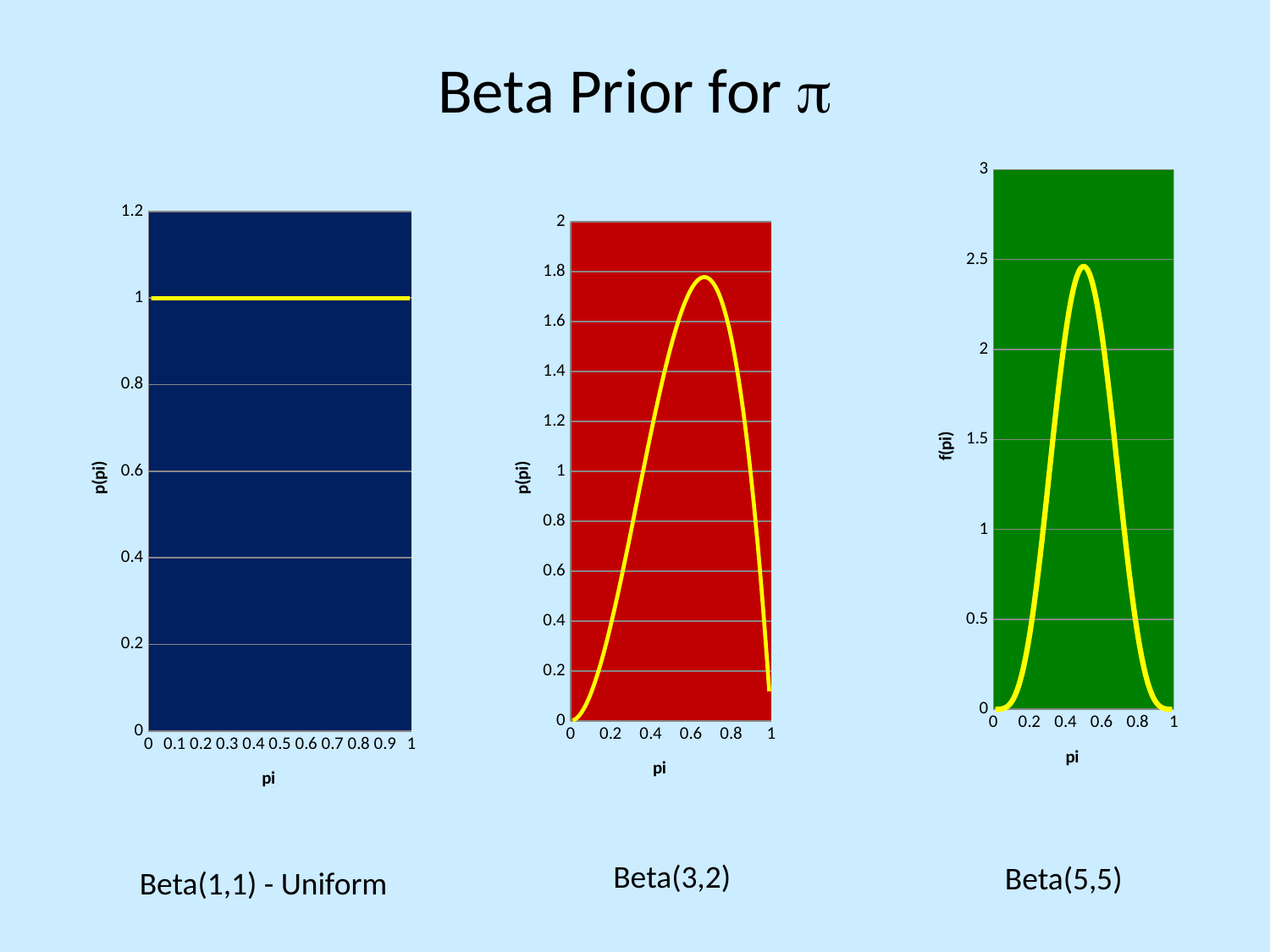
What is the y-axis label of the Beta(5,5) chart on the right? f(pi) In the Beta(5,5) chart on the right, does the curve rise then fall, or fall then rise, as pi goes from 0 to 1? rises then falls In the Beta(3,2) chart in the middle, what is the value of p(pi) at pi = 0? 0 In the Beta(3,2) chart in the middle, is the value of the curve at pi = 0.2 greater or less than 1? less In the Beta(5,5) chart on the right, is the value of the curve at pi = 0.2 greater or less than 1? less What is the background colour of the plot area in the Beta(3,2) chart in the middle? red In the Beta(5,5) chart on the right, is the peak value of the curve greater or less than 2? greater Which chart has the higher peak value: the Beta(3,2) chart in the middle or the Beta(5,5) chart on the right? Beta(5,5) In the Beta(1,1) - Uniform chart on the left, what is the value of p(pi) across the whole range of pi? 1 In the Beta(1,1) - Uniform chart on the left, does the line rise, fall, or stay flat as pi increases from 0 to 1? stays flat What kind of chart is the Beta(1,1) - Uniform chart on the left? line chart